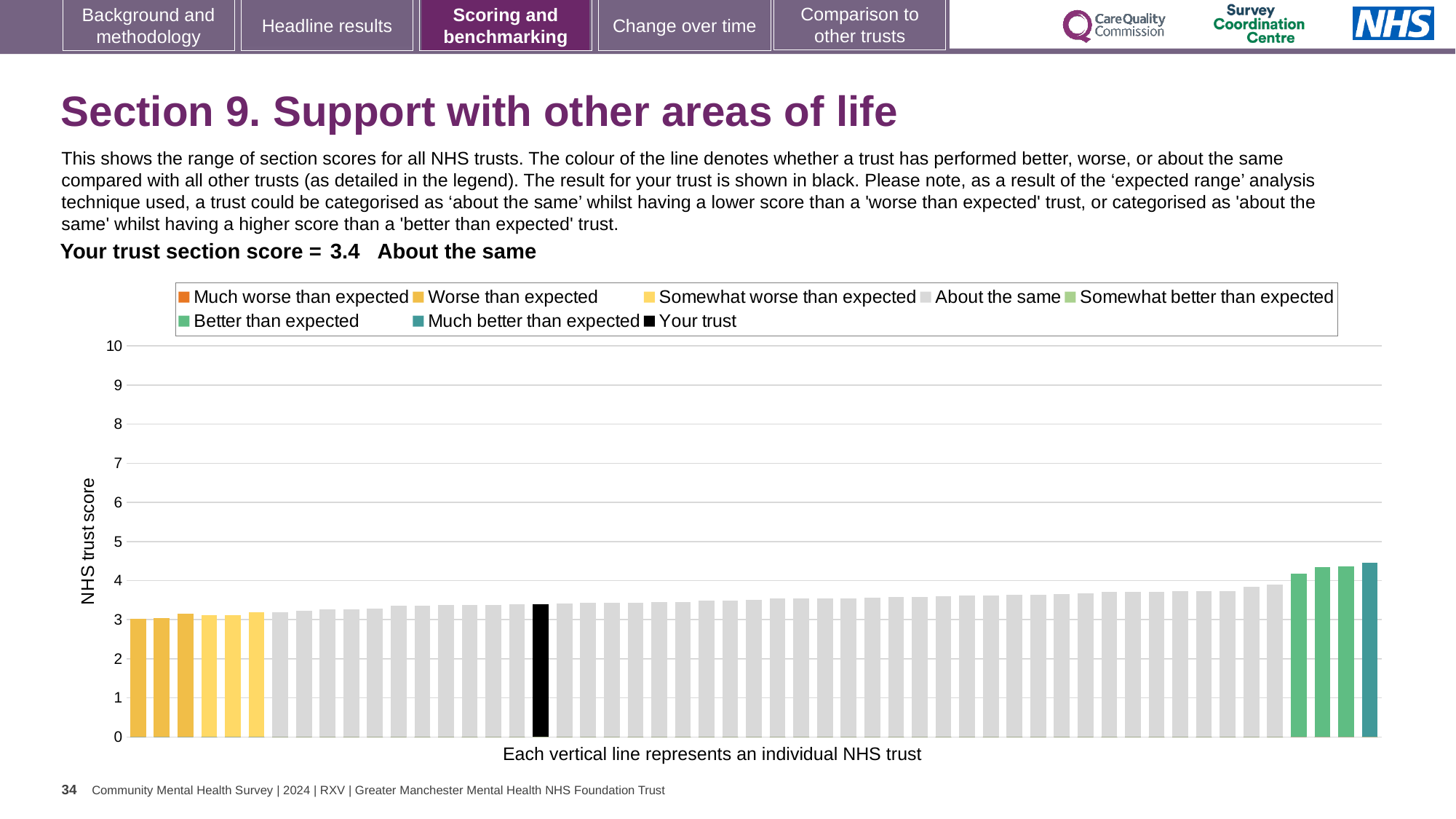
Is the value for your trust greater or less than 5? less Is the value of the leftmost bar greater or less than 4? less Which is higher, the rightmost bar or the bar for your trust? The rightmost bar Which is higher, the bar for your trust or the leftmost bar? Your trust Is the value of the tallest bar (rightmost) greater or less than 4? greater What colour is the bar representing your trust? Black Which legend category does the tallest bar belong to? Much better than expected Do the bar values rise or fall from left to right along the x axis? rise How many entries does the chart legend list? 8 What kind of chart is shown on the slide? bar chart What is the label on the vertical axis of the chart? NHS trust score What is the section score for your trust shown on the slide? 3.4